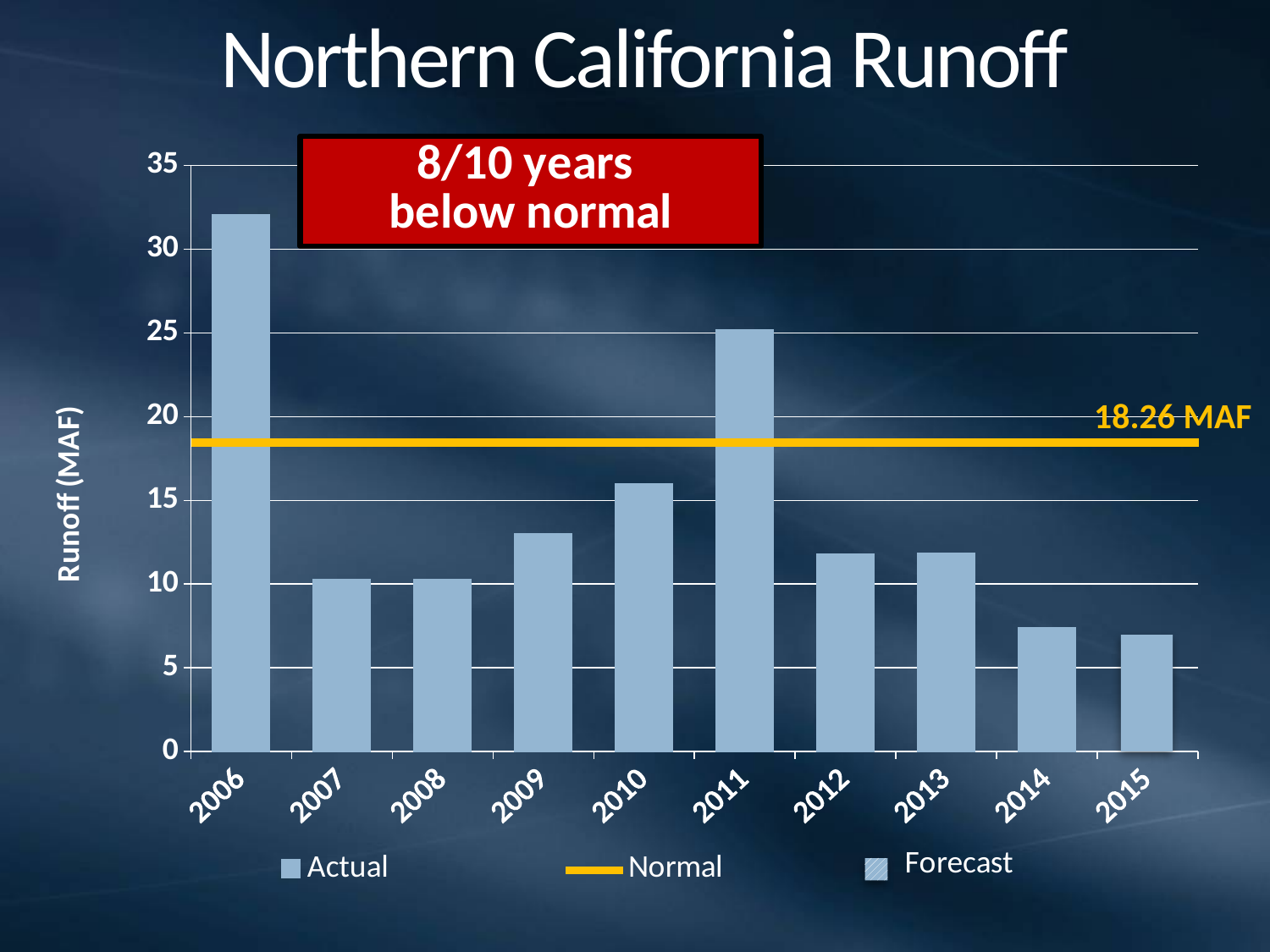
Do the actual runoff values rise or fall from 2011 to 2015? fall Is the actual runoff for 2006 greater or less than 30? greater How many series does the legend list? 3 How many years are shown on the x axis of the chart? 10 What is the value of the Normal runoff line? 18.26 MAF Which year has the highest actual runoff? 2006 What kind of chart is shown on the slide? bar chart Is the actual runoff for 2014 greater or less than 10? less Which year has the larger actual runoff, 2009 or 2010? 2010 Is the actual runoff for 2010 greater or less than 20? less What does the red box on the chart say? 8/10 years below normal